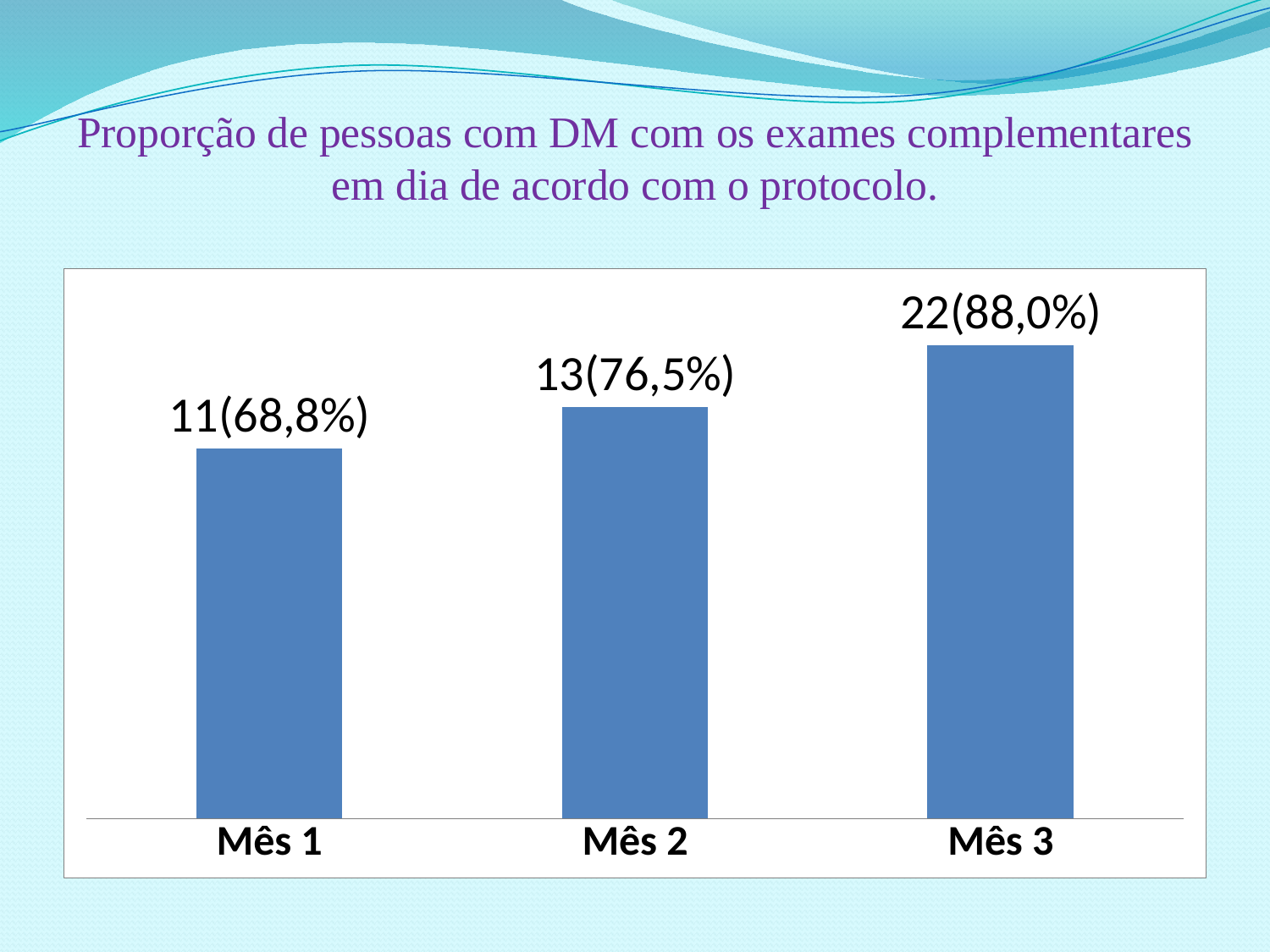
How many categories are shown on the x axis? 3 Which month has the lowest value? Mês 1 What is the difference in percentage points between Mês 3 and Mês 1? 19,2 Which is larger, the value for Mês 2 or the value for Mês 1? Mês 2 Which month has the highest value? Mês 3 What is the data label shown for Mês 3? 22(88,0%) What is the data label shown for Mês 2? 13(76,5%) What percentage is shown for Mês 3? 88,0% What is the title of the slide above the chart? Proporção de pessoas com DM com os exames complementares em dia de acordo com o protocolo. What kind of chart is shown on the slide? Bar chart What is the data label shown for Mês 1? 11(68,8%) Do the values rise or fall from Mês 1 to Mês 3? Rise